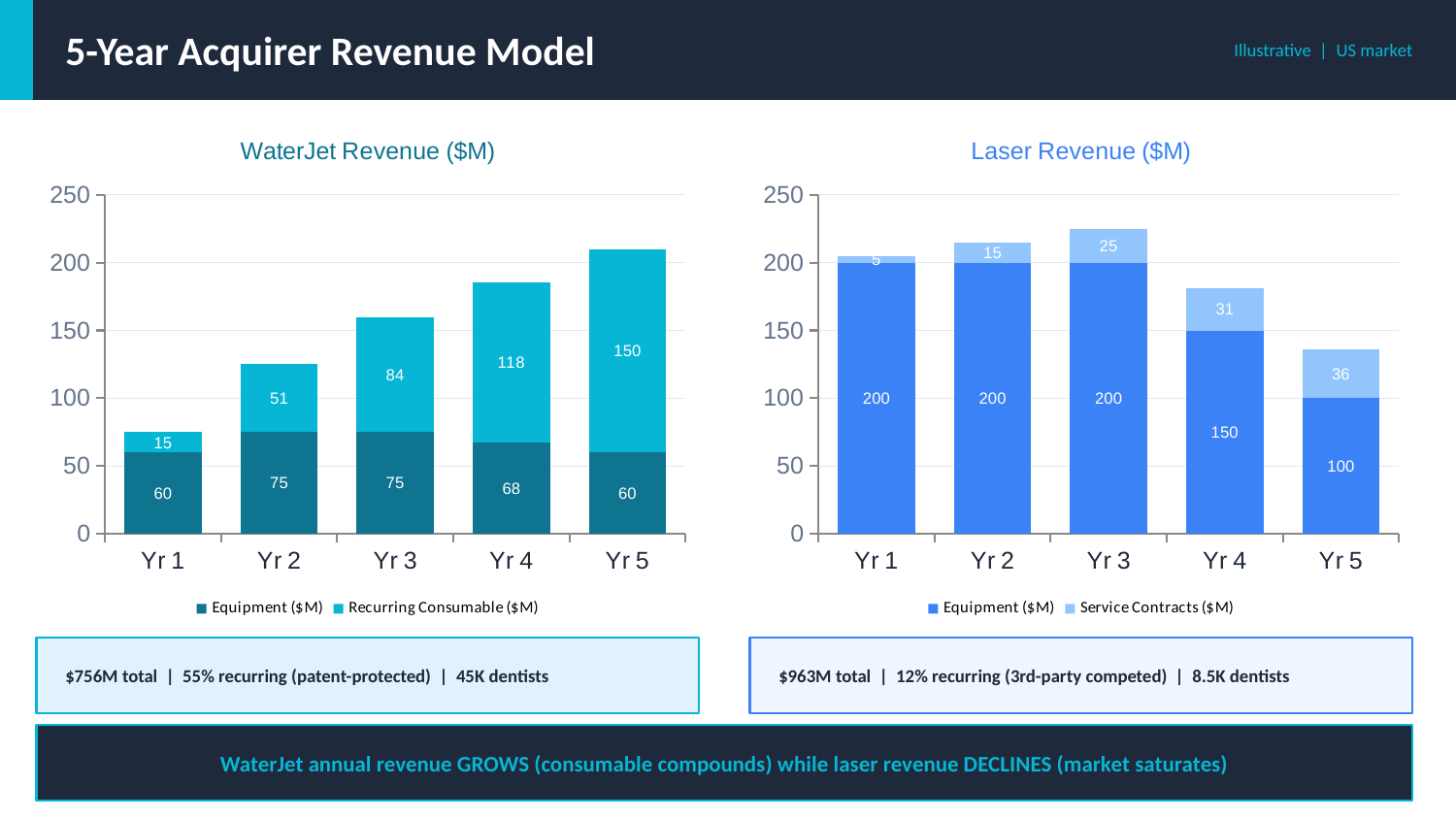
In the WaterJet Revenue ($M) chart, which year has the highest Recurring Consumable value? Yr 5 In the Laser Revenue ($M) chart, which year has the lowest Service Contracts value? Yr 1 How many series does the legend of the Laser Revenue ($M) chart list? 2 In the WaterJet Revenue ($M) chart, what is the total of the stacked bar for Yr 5? 210 In the WaterJet Revenue ($M) chart, what is the Recurring Consumable value for Yr 3? 84 In the Laser Revenue ($M) chart, what is the Equipment value for Yr 4? 150 How many years are shown on the x axis of the WaterJet Revenue ($M) chart? 5 In the WaterJet Revenue ($M) chart, what is the difference between the Recurring Consumable values for Yr 5 and Yr 4? 32 In the Laser Revenue ($M) chart, which is larger: the Equipment value for Yr 3 or for Yr 5? Yr 3 In the Laser Revenue ($M) chart, what is the total of the stacked bar for Yr 4? 181 What kind of chart is the WaterJet Revenue ($M) chart? Stacked bar chart In the Laser Revenue ($M) chart, is the total for Yr 5 greater or less than 150? less